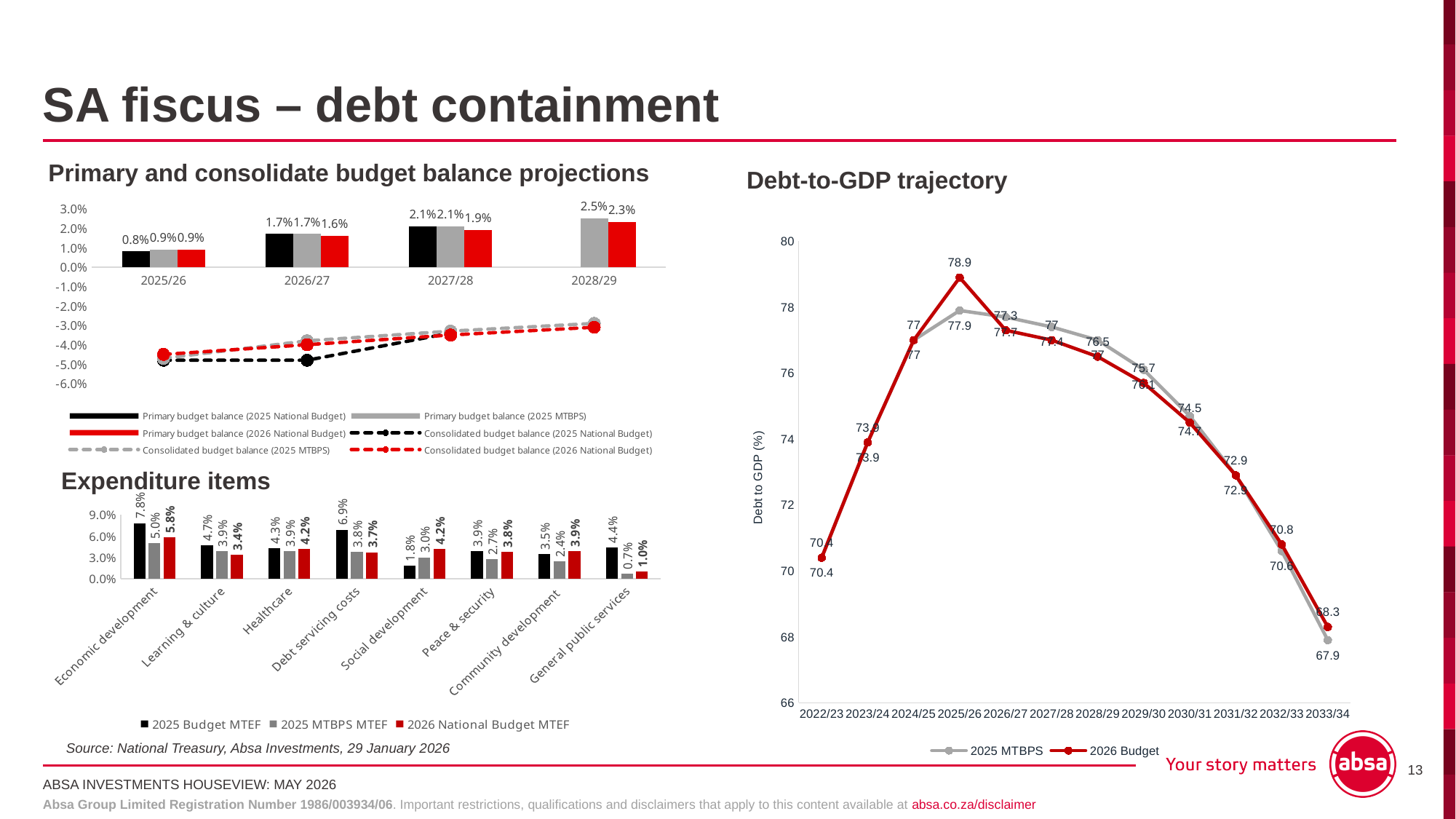
In the Debt-to-GDP trajectory chart, what is the 2025 MTBPS value for 2033/34? 67.9 In the Expenditure items chart, which category has the highest 2025 Budget MTEF value? Economic development In the Debt-to-GDP trajectory chart, what is the peak value of the 2026 Budget series? 78.9 In the Expenditure items chart, which category has the lowest 2025 MTBPS MTEF value? General public services In the Expenditure items chart, what is the difference between the 2025 Budget MTEF and 2026 National Budget MTEF values for Debt servicing costs? 3.2 percentage points In the Debt-to-GDP trajectory chart, is the 2026 Budget value for 2025/26 greater or less than 78? greater In the Primary and consolidate budget balance projections chart, do the primary budget balance bars rise or fall from 2025/26 to 2028/29? rise In the Debt-to-GDP trajectory chart, how many series does the legend list? 2 In the Debt-to-GDP trajectory chart, how many fiscal years are shown on the x axis? 12 In the Primary and consolidate budget balance projections chart, what is the Primary budget balance (2026 National Budget) for 2028/29? 2.3% In the Expenditure items chart, what is the 2026 National Budget MTEF value for Economic development? 5.8% In the Debt-to-GDP trajectory chart, what is the 2026 Budget value for 2033/34? 68.3